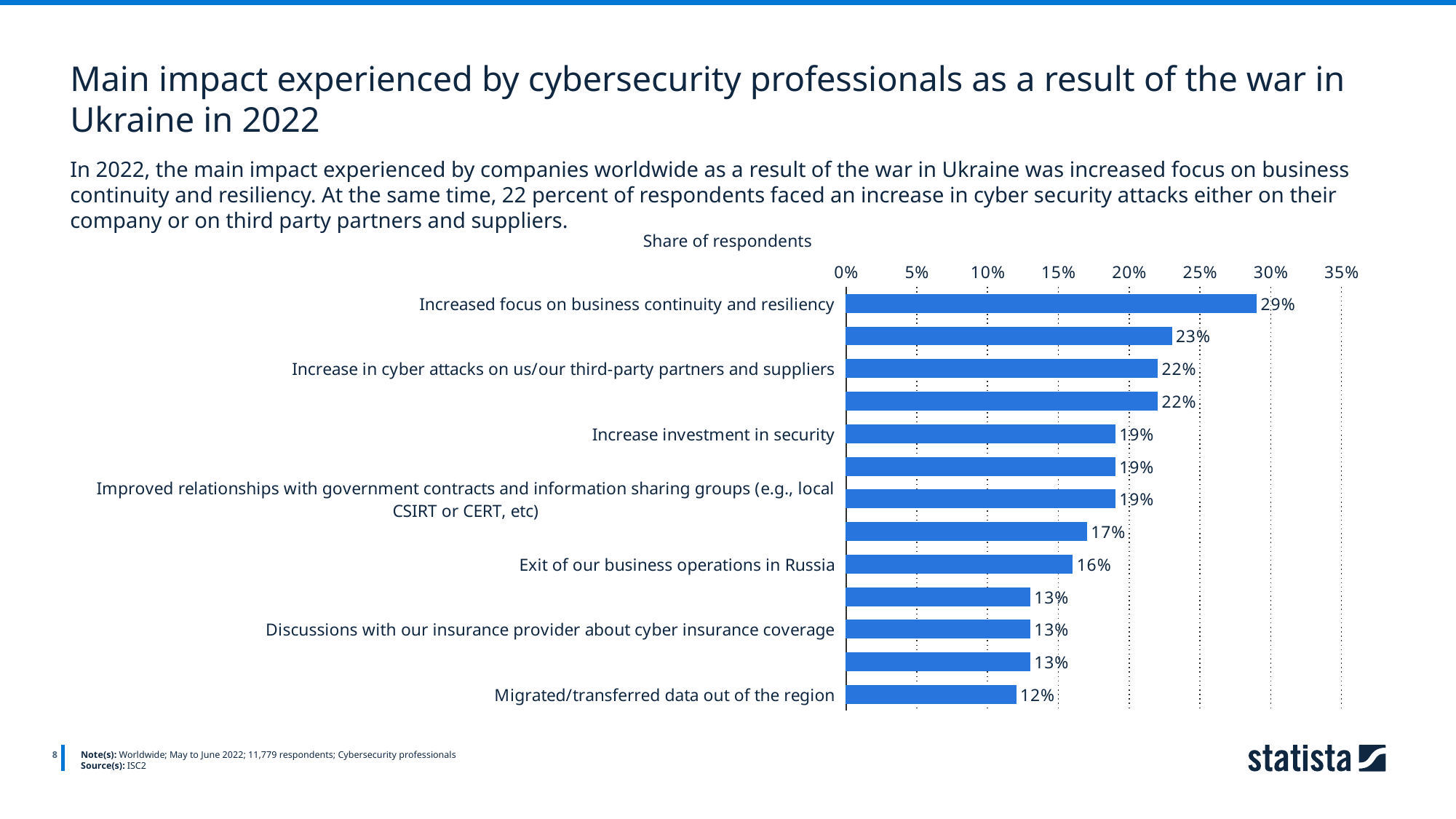
What is the label of the value axis of the chart? Share of respondents Which has a larger share of respondents: 'Increase investment in security' or 'Discussions with our insurance provider about cyber insurance coverage'? Increase investment in security Which impact has the highest share of respondents? Increased focus on business continuity and resiliency How many bars are plotted in the chart? 13 Which impact has the lowest share of respondents? Migrated/transferred data out of the region What share of respondents reported migrating or transferring data out of the region? 12% What type of chart is shown on the slide? Bar chart What is the difference in share of respondents between 'Increased focus on business continuity and resiliency' and 'Exit of our business operations in Russia'? 13% What share of respondents reported exiting business operations in Russia? 16% What share of respondents reported increased focus on business continuity and resiliency? 29% What share of respondents reported an increase in cyber attacks on them or their third-party partners and suppliers? 22% What share of respondents reported increased investment in security? 19%